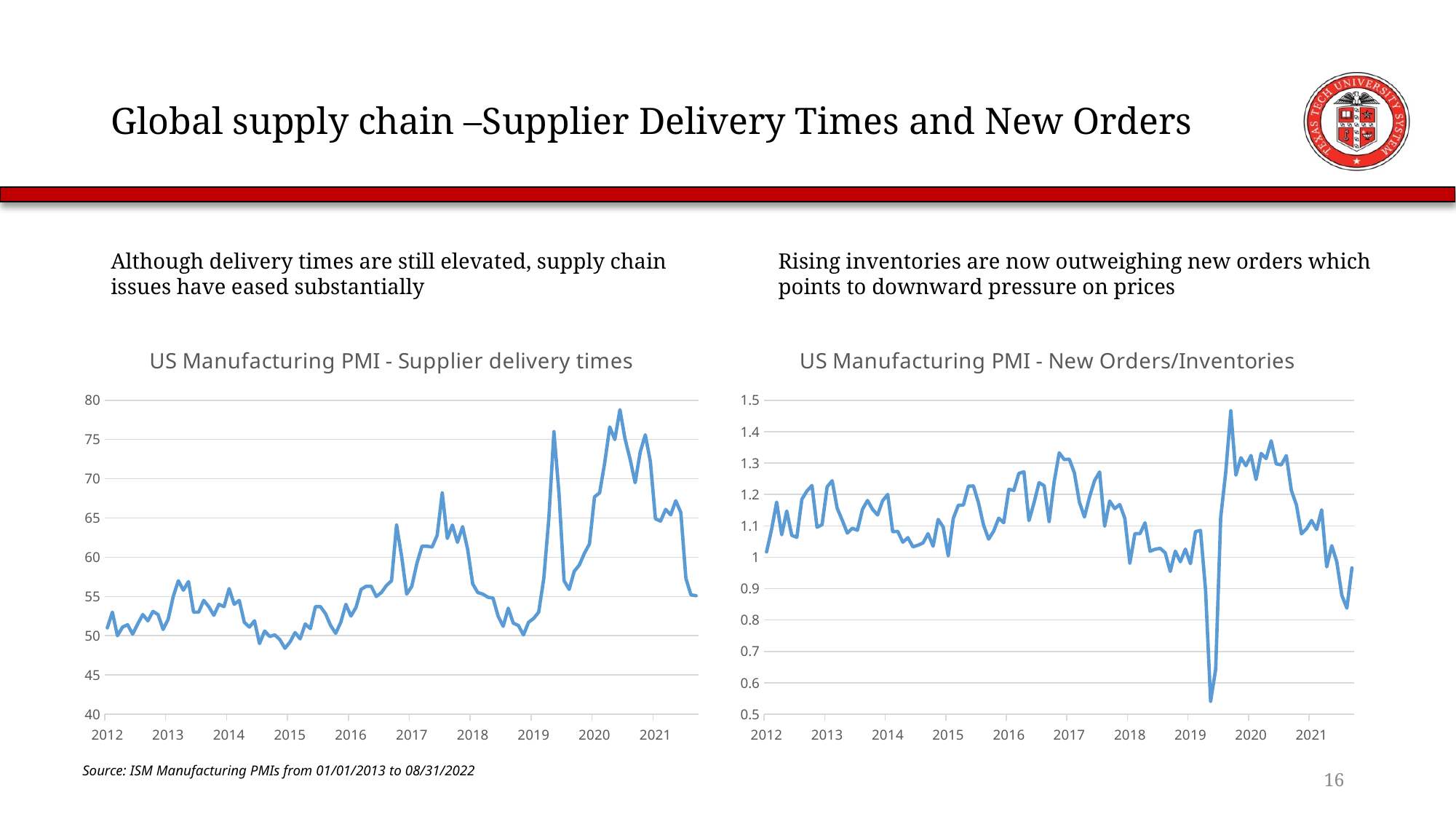
On the left chart (Supplier delivery times), is the value at the start of 2012 greater or less than 50? greater What kind of chart is the right chart, 'US Manufacturing PMI - New Orders/Inventories'? line chart How many lines are plotted on the right chart (New Orders/Inventories)? 1 What kind of chart is the left chart, 'US Manufacturing PMI - Supplier delivery times'? line chart On the right chart (New Orders/Inventories), is the lowest value, reached in 2019, greater or less than 0.6? less On the left chart (Supplier delivery times), do the values rise or fall from the 2020 peak to the end of the series? fall On the left chart (Supplier delivery times), is the peak value reached around 2020 greater or less than 75? greater What is the title of the right chart? US Manufacturing PMI - New Orders/Inventories How many year labels are shown on the x axis of the left chart (Supplier delivery times)? 10